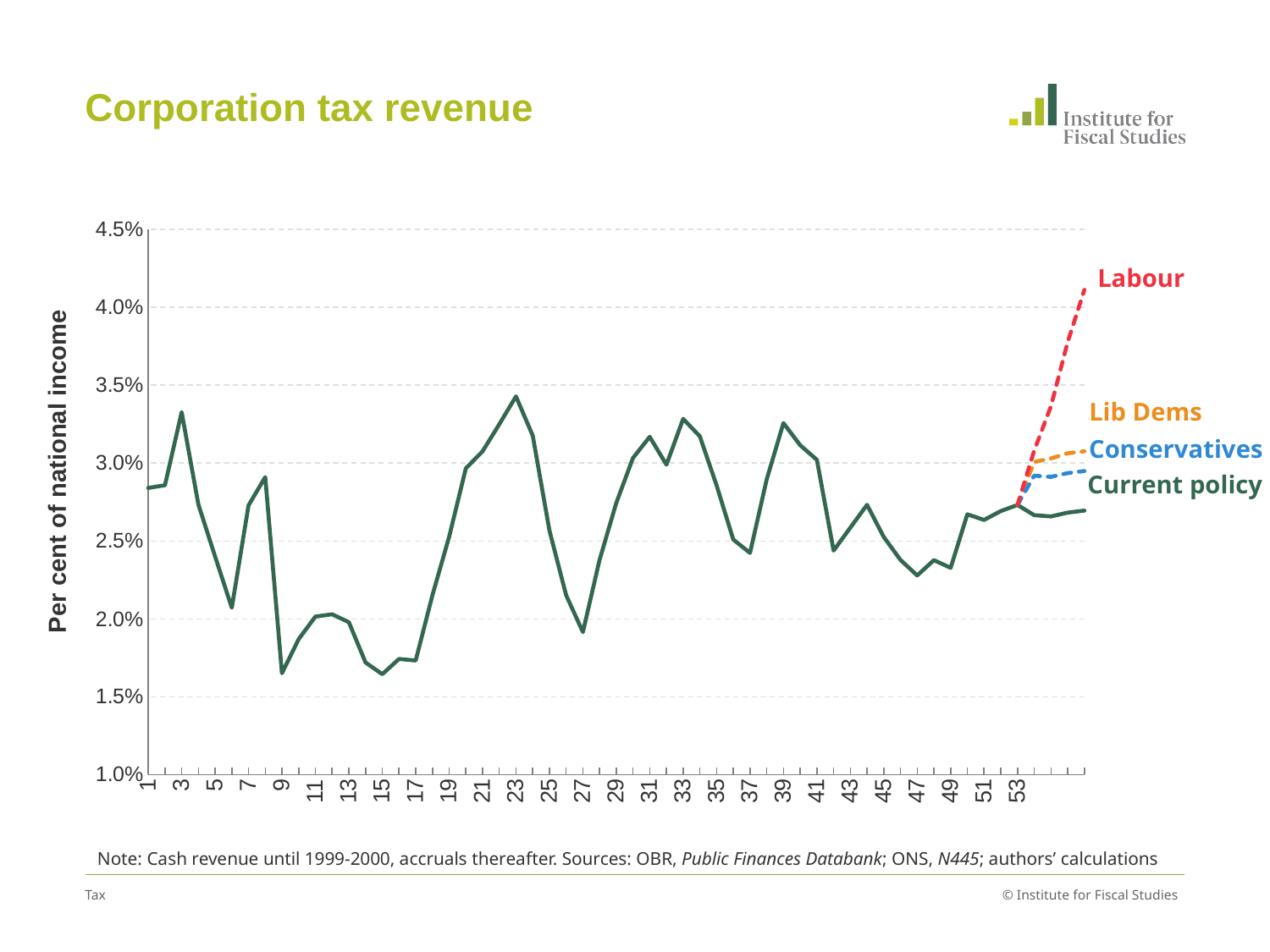
Is the value of the Labour projection at the right end of the chart greater or less than 3.5%? greater Which ends higher on the right of the chart, the Lib Dems line or the Conservatives line? Lib Dems Is the value of the green line at x = 9 greater or less than 2.0%? less How many labelled series (lines) does the chart show? 4 Which projection line ends at the highest value on the right of the chart? Labour What is the title of the chart? Corporation tax revenue Which is higher, the value of the green line at x = 23 or at x = 9? x = 23 Is the value of the green line at x = 23 greater or less than 3.0%? greater Which of the four labelled lines ends at the lowest value on the right of the chart? Current policy What kind of chart is shown on the slide? Line chart What is the label on the vertical axis? Per cent of national income